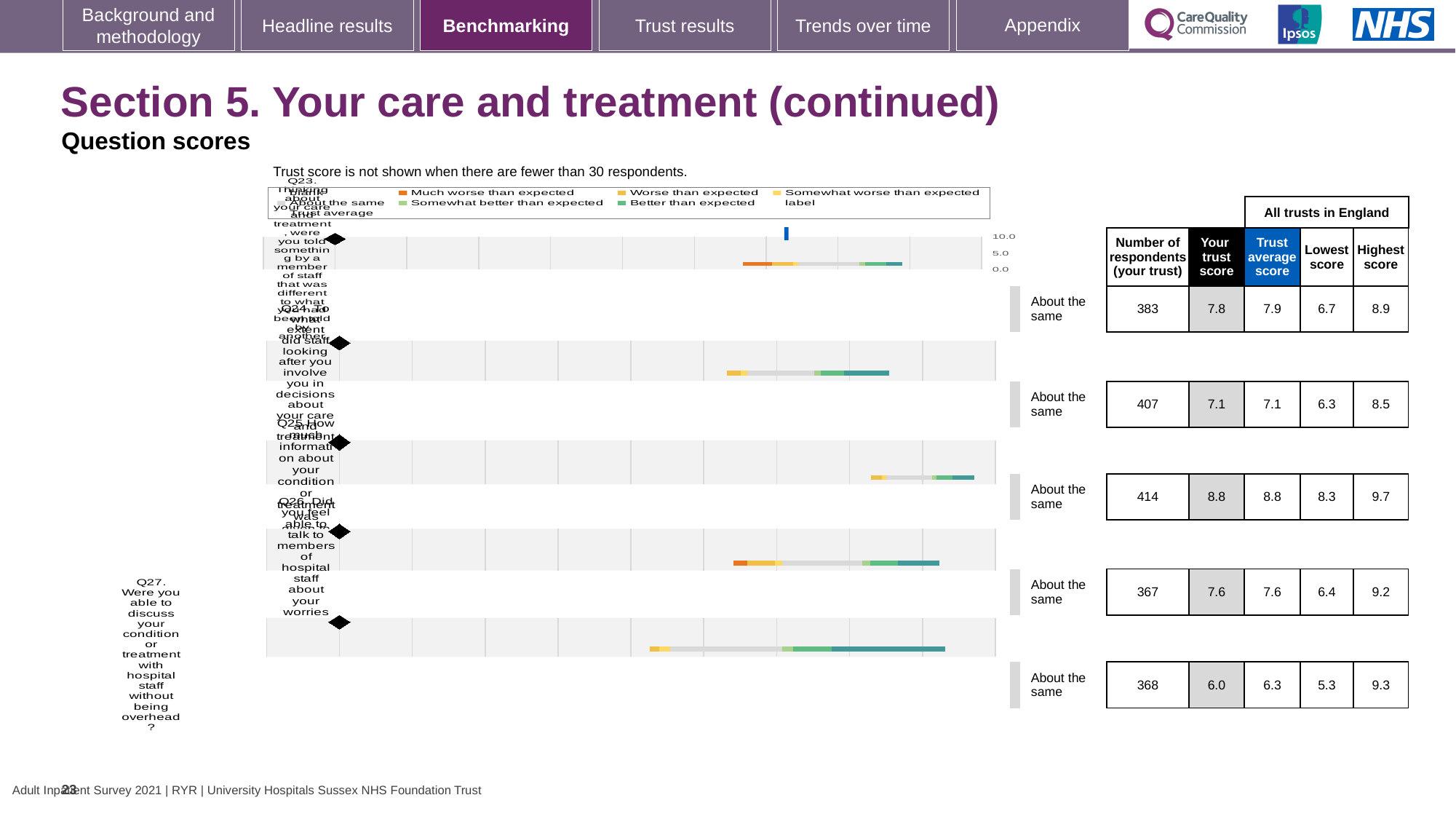
What kind of chart is used to show the question scores? Bar chart For Q27, what is the difference between the trust average score and your trust score? 0.3 What is the trust average score for Q23, about being told something different by another member of staff? 7.9 How many respondents answered Q25, about how much information was given about your condition or treatment? 414 Which question has the highest 'Your trust score' on this slide? Q25 How many questions are plotted on the chart? 5 Which has the larger 'Your trust score': Q23 or Q24? Q23 What is the highest score across all trusts in England for Q26, about being able to talk to hospital staff about your worries? 9.2 What benchmark category is shown next to every question on this slide? About the same What is the lowest score across all trusts in England for Q27? 5.3 What is the trust score (your trust) for Q27, about discussing your condition or treatment without being overheard? 6.0 Which question has the lowest 'Your trust score' on this slide? Q27